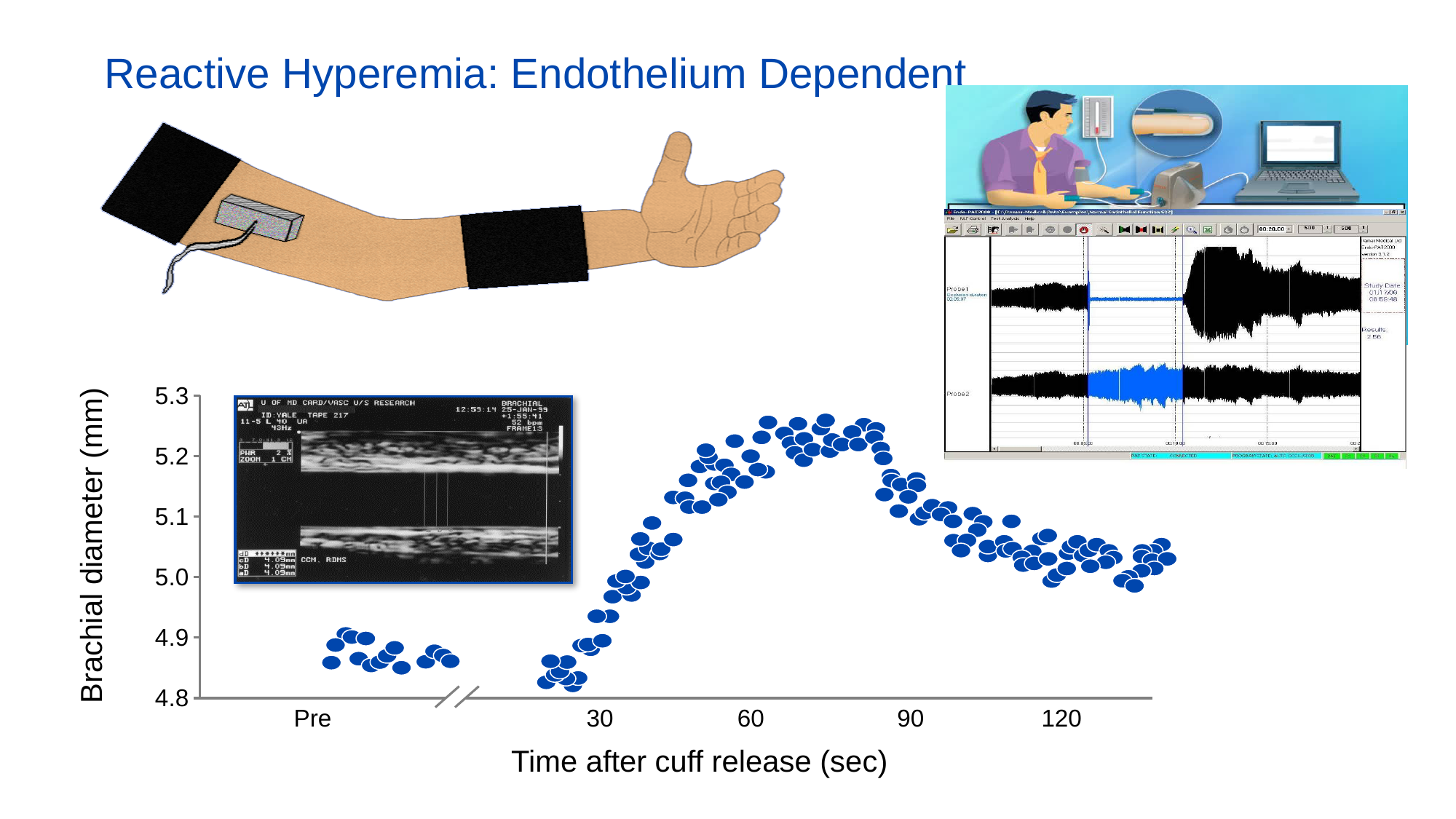
Which is larger, the brachial diameter at 90 seconds or at 120 seconds after cuff release? 90 seconds Are the brachial diameter values at 30 seconds after cuff release greater or less than 5.0 mm? less What is the label of the x axis of the scatter plot? Time after cuff release (sec) Which is larger, the brachial diameter at 60 seconds after cuff release or in the Pre period? 60 seconds after cuff release What kind of chart is shown at the bottom of the slide? scatter plot What is the label of the y axis of the scatter plot? Brachial diameter (mm) What is the highest value shown on the y axis of the scatter plot? 5.3 Are the brachial diameter values in the Pre period greater or less than 5.0 mm? less Does the brachial diameter rise or fall between 30 and 60 seconds after cuff release? rise Are the peak brachial diameter values around 60 to 75 seconds after cuff release greater or less than 5.2 mm? greater Does the brachial diameter rise or fall between 90 and 120 seconds after cuff release? fall